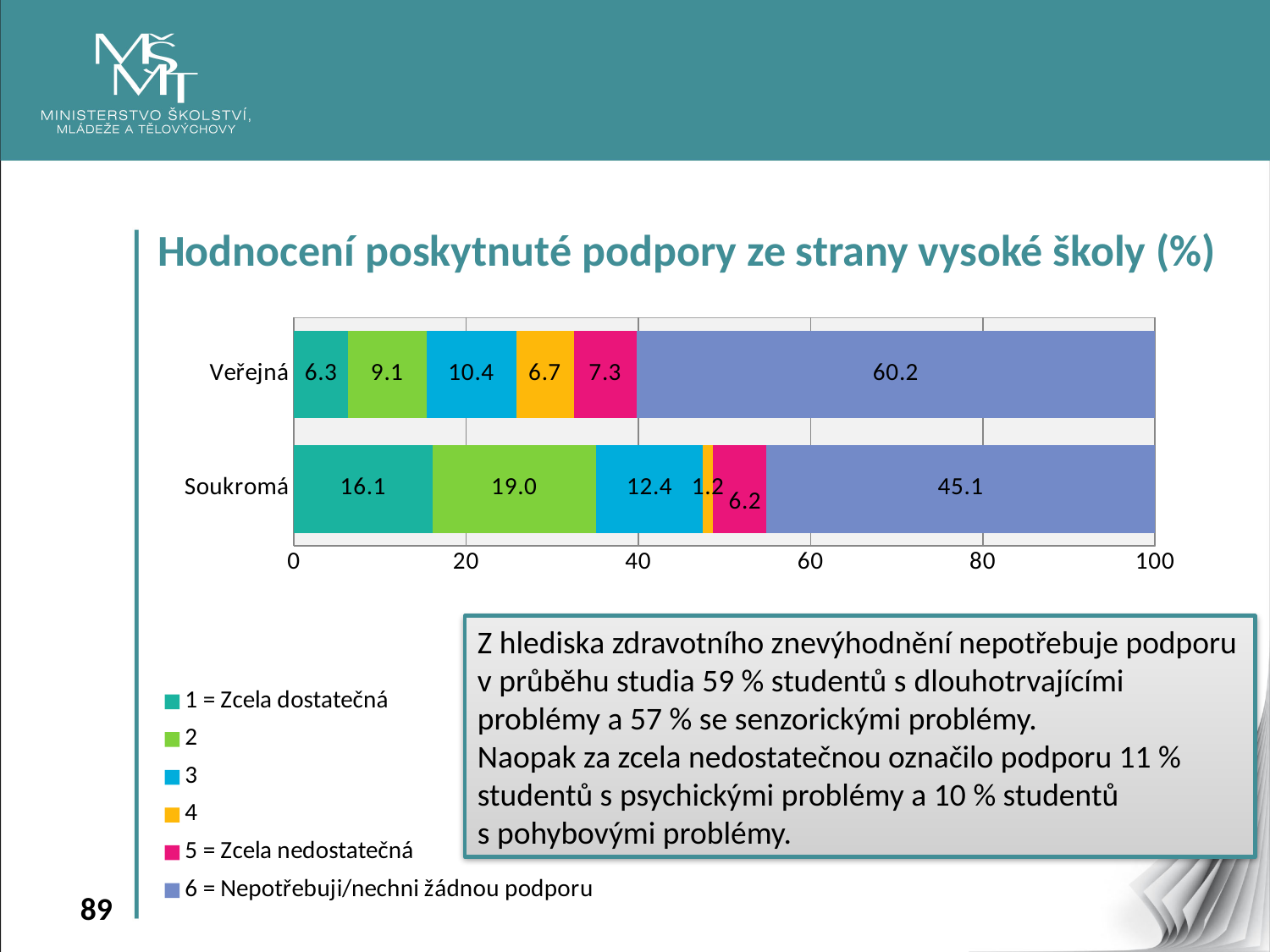
Which series has the smallest value within the Soukromá bar? 4 What is the title of the chart? Hodnocení poskytnuté podpory ze strany vysoké školy (%) What is the value of series "1 = Zcela dostatečná" for Soukromá? 16.1 What kind of chart is shown on the slide? Stacked bar chart What is the difference between the values of series "6 = Nepotřebuji/nechni žádnou podporu" for Veřejná and Soukromá? 15.1 Which category has the higher value for series "2", Veřejná or Soukromá? Soukromá What is the value of series "4" for Soukromá? 1.2 How many series does the legend list? 6 Which series has the largest value within the Veřejná bar? 6 = Nepotřebuji/nechni žádnou podporu What is the value of series "6 = Nepotřebuji/nechni žádnou podporu" for Veřejná? 60.2 What is the value of series "5 = Zcela nedostatečná" for Veřejná? 7.3 How many categories are shown on the chart? 2